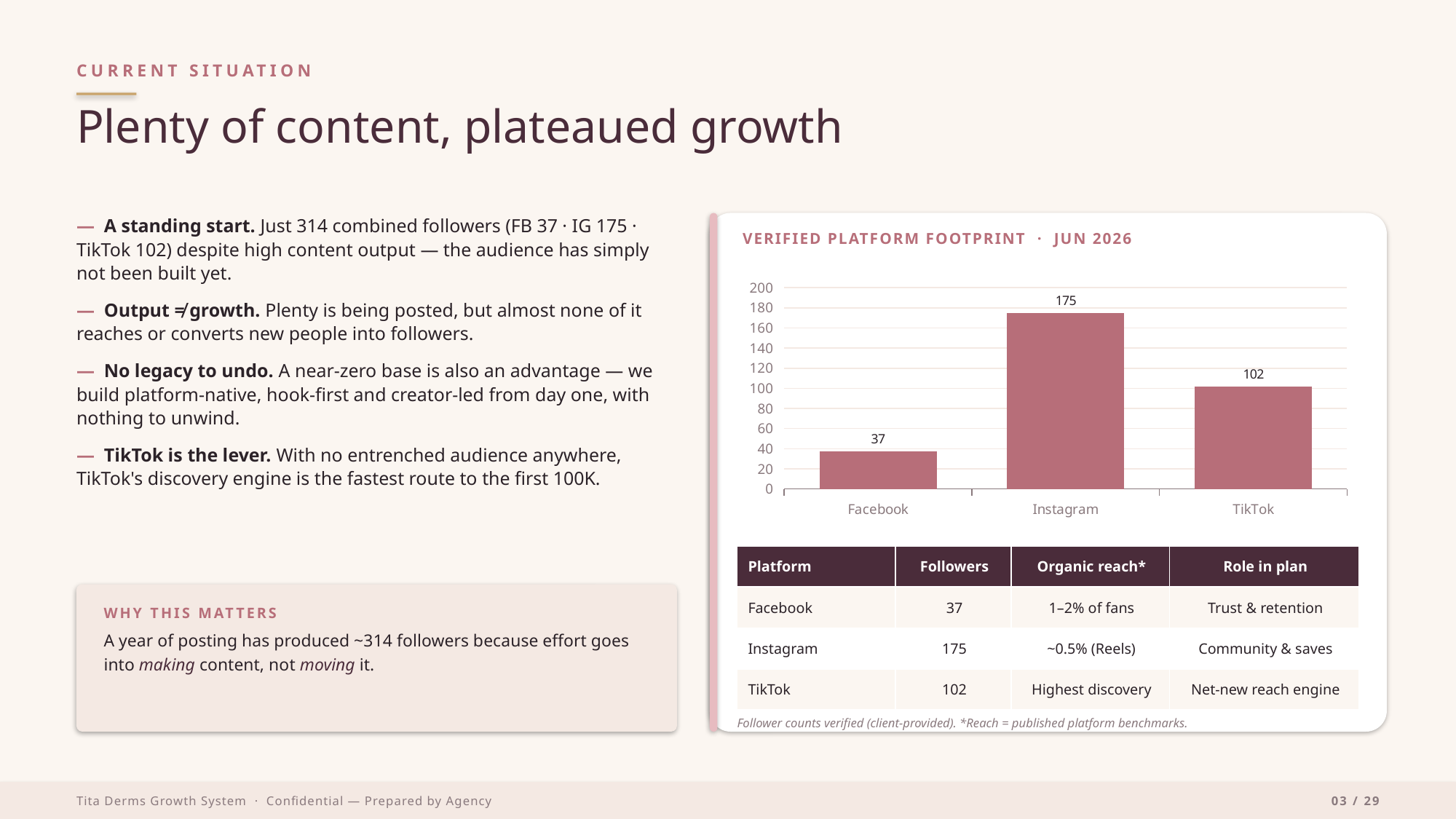
What is the value for Instagram in the chart? 175 How many platforms are shown in the chart? 3 Is the value for TikTok in the chart greater or less than 100? greater What kind of chart is shown on the slide? Bar chart Which is larger in the chart, the value for TikTok or the value for Facebook? TikTok Which platform has the highest value in the chart? Instagram What is the value for TikTok in the chart? 102 What is the difference between the Instagram and TikTok values in the chart? 73 Which platform has the lowest value in the chart? Facebook What is the title of the chart? Verified Platform Footprint · Jun 2026 What is the difference between the TikTok and Facebook values in the chart? 65 What is the value for Facebook in the chart? 37